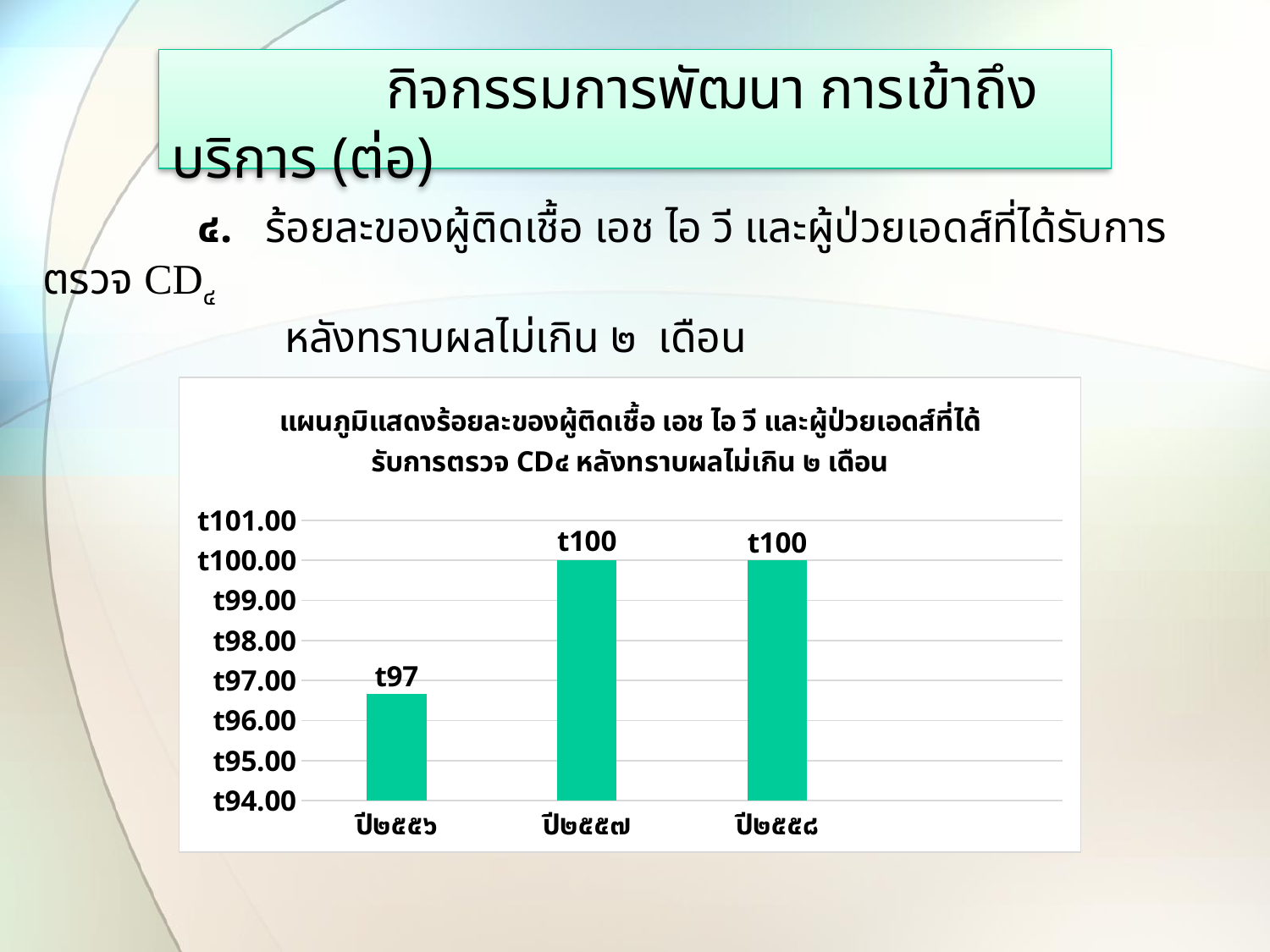
What is the value shown for ปี๒๕๕๘? t100 Do the values rise or fall from ปี๒๕๕๖ to ปี๒๕๕๗? rise What is the value shown for ปี๒๕๕๖? t97 What is the lowest tick label on the vertical axis? t94.00 Which year has the lowest value? ปี๒๕๕๖ What is the value shown for ปี๒๕๕๗? t100 What kind of chart is shown on the slide? bar chart What colour are the bars in the chart? green Is the value for ปี๒๕๕๘ greater or less than 99.00? greater Is the value for ปี๒๕๕๖ greater or less than 98.00? less Which is larger, the value for ปี๒๕๕๖ or the value for ปี๒๕๕๗? ปี๒๕๕๗ How many years are shown on the x axis? 3